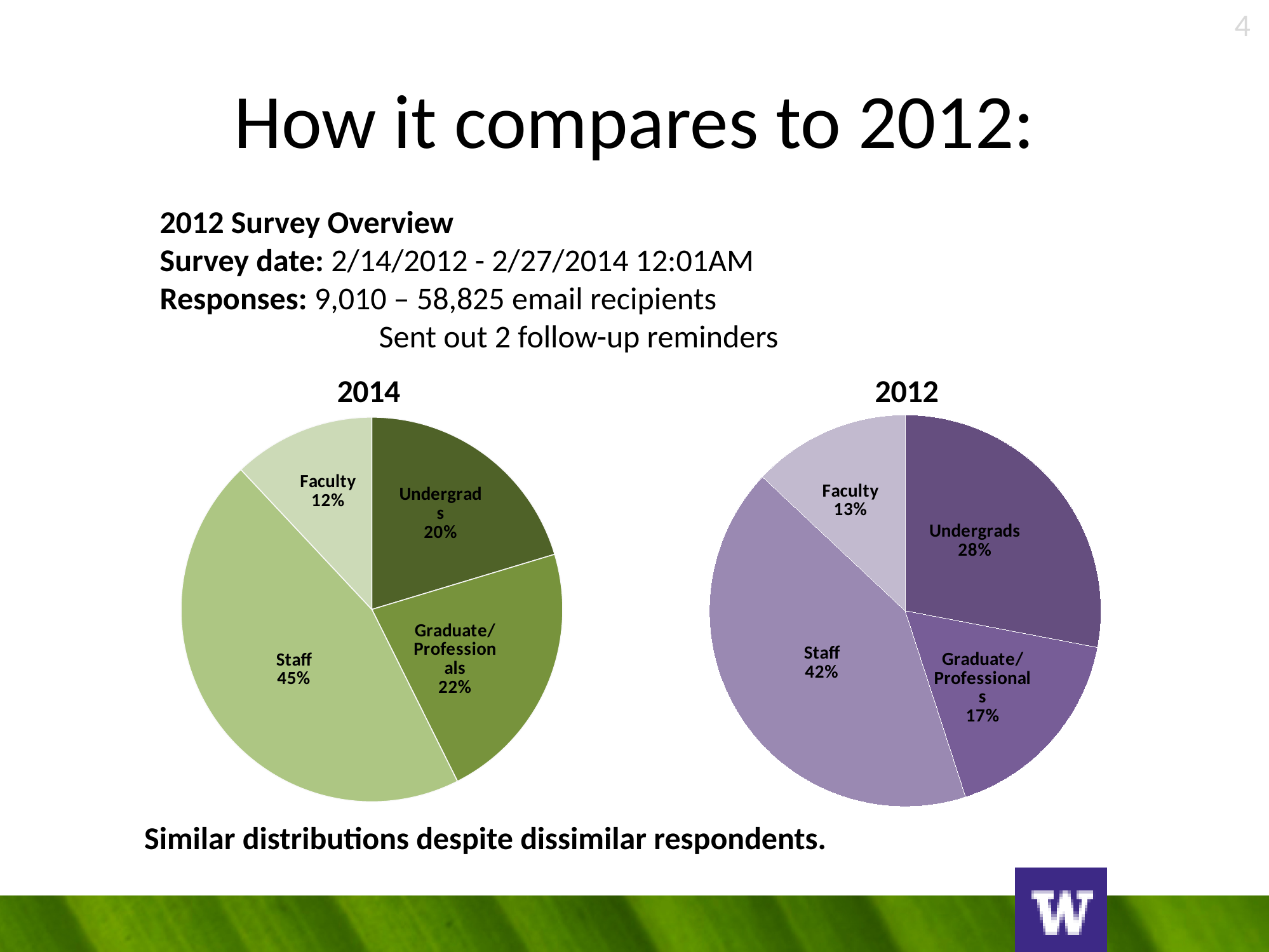
What is the title of the chart on the right side of the slide? 2012 In the 2012 pie chart, what share of respondents are Faculty? 13% In the 2012 pie chart, what share of respondents are Undergrads? 28% Which is larger: the Graduate/Professionals share in the 2014 chart or in the 2012 chart? 2014 In the 2014 pie chart, which category has the largest share? Staff What type of chart is used for the 2012 data? Pie chart In the 2014 pie chart, what share of respondents are Graduate/Professionals? 22% What is the difference between the Staff share and the Faculty share in the 2014 chart? 33% How many categories does the 2014 pie chart show? 4 In the 2012 pie chart, which category has the smallest share? Faculty In the 2014 pie chart, what share of respondents are Staff? 45% What is the difference between the Undergrads share in the 2012 chart and the Undergrads share in the 2014 chart? 8%